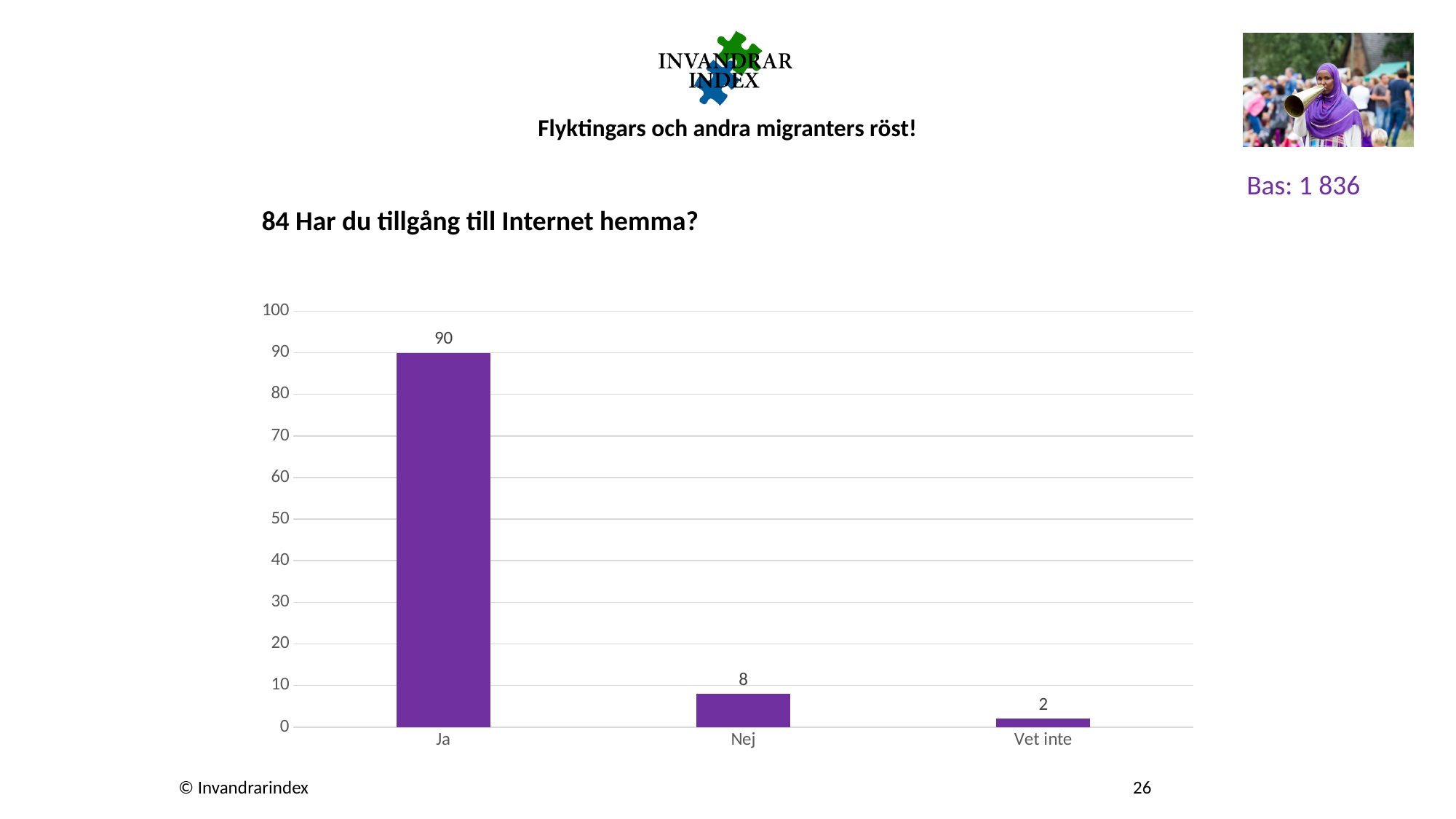
Which category has the lowest value? Vet inte What is the value for "Nej"? 8 What is the value for "Ja"? 90 Which category has the highest value? Ja How many categories are shown on the x axis? 3 Is the value for "Ja" greater or less than 50? greater What is the value for "Vet inte"? 2 What is the difference between the values for "Ja" and "Nej"? 82 What is the title of the chart? 84 Har du tillgång till Internet hemma? Which is larger, the value for "Nej" or the value for "Vet inte"? Nej What is the difference between the values for "Nej" and "Vet inte"? 6 What kind of chart is shown on the slide? bar chart